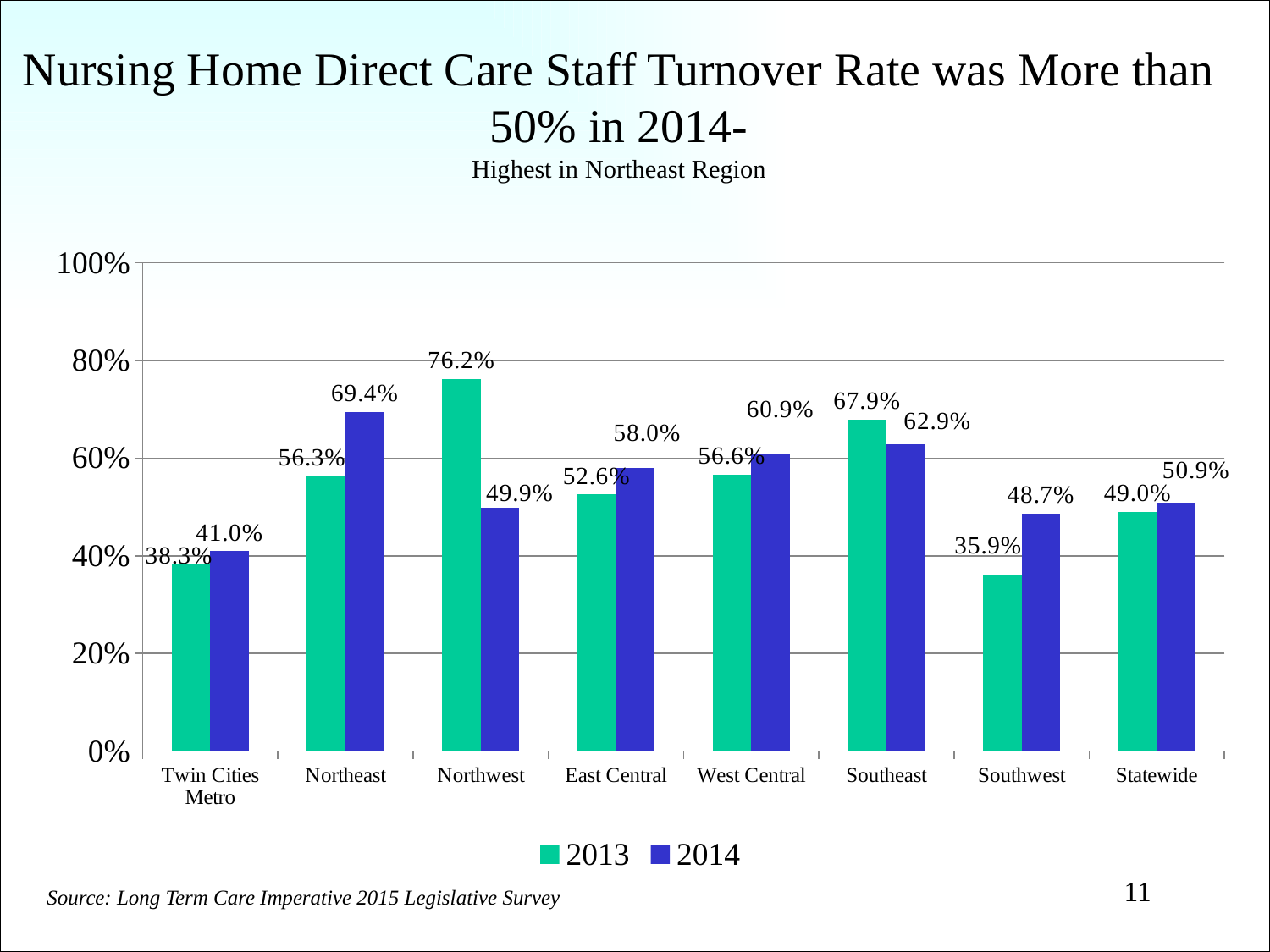
What was the 2014 turnover rate for the Northeast region? 69.4% What kind of chart is shown on the slide? bar chart How many regions (categories) are shown on the x axis? 8 Is the 2013 turnover rate for Twin Cities Metro greater or less than 40%? less Which colour represents the 2014 series in the chart? blue What was the Statewide turnover rate in 2014? 50.9% Which was larger for the Southeast region, the 2013 or the 2014 turnover rate? 2013 What is the difference between the 2013 and 2014 turnover rates for the Northwest region? 26.3% What was the 2013 turnover rate for the Northwest region? 76.2% How many series does the legend list? 2 Which region had the highest 2014 turnover rate? Northeast Which region had the lowest 2013 turnover rate? Southwest